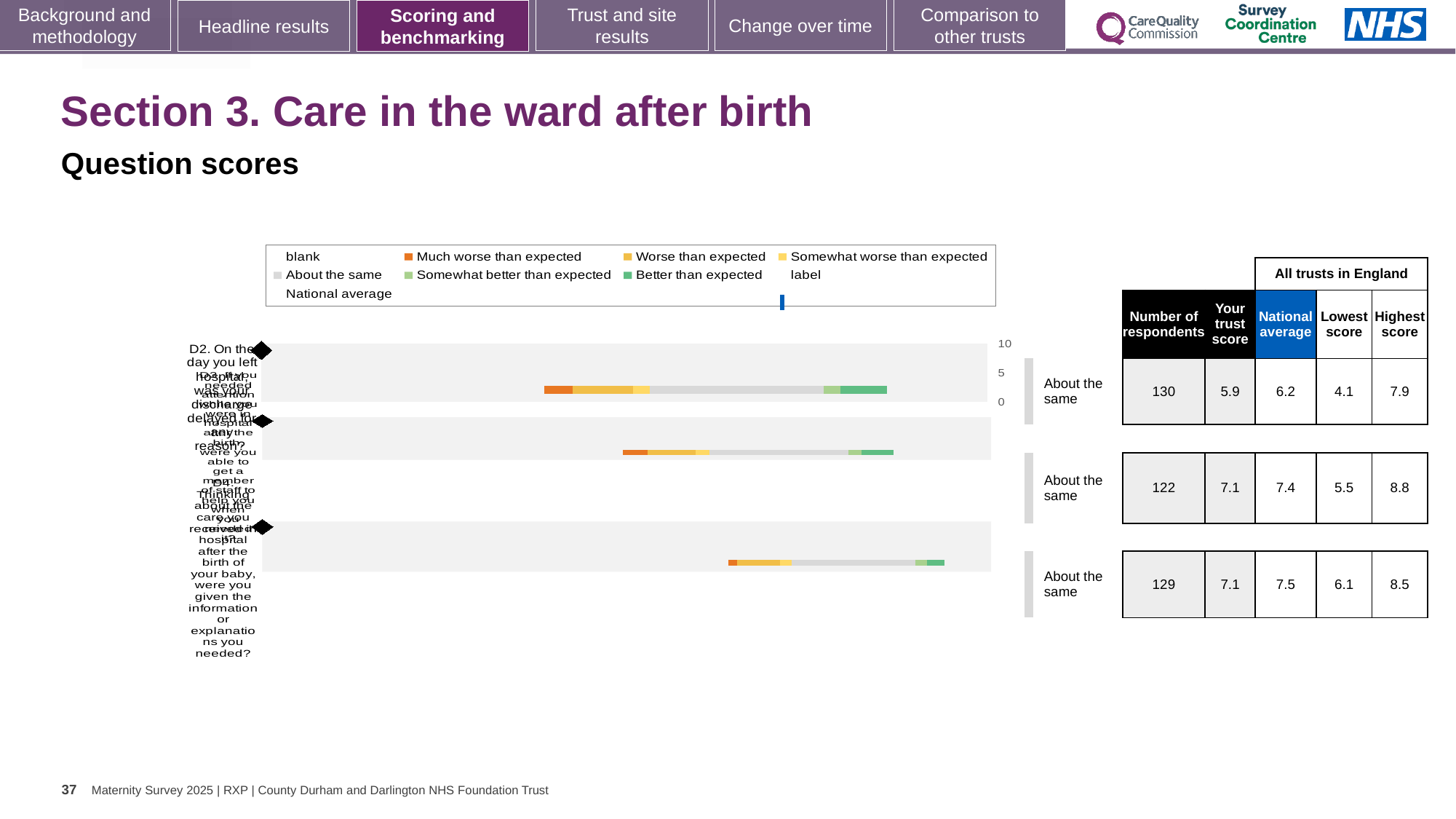
In the table beside the chart, what is the difference between the national average and the trust score in the first row? 0.3 In the table beside the chart, which row has the lowest 'Your trust score'? the first row (5.9) In the chart legend, what does the dark green segment represent? Better than expected In the chart legend, which colour represents 'Much worse than expected'? orange In the table beside the chart, what is the 'Your trust score' value in the first row? 5.9 In the table beside the chart, is the national average larger in the second row or the third row? the third row (7.5) How many horizontal bars are plotted in the chart? 3 In the table beside the chart, what is the lowest score in the third row? 6.1 In the table beside the chart, what is the highest score in the second row? 8.8 What kind of chart is shown on the slide? bar chart In the table beside the chart, what is the number of respondents in the first row? 130 What benchmark label is shown next to each of the three bars? About the same